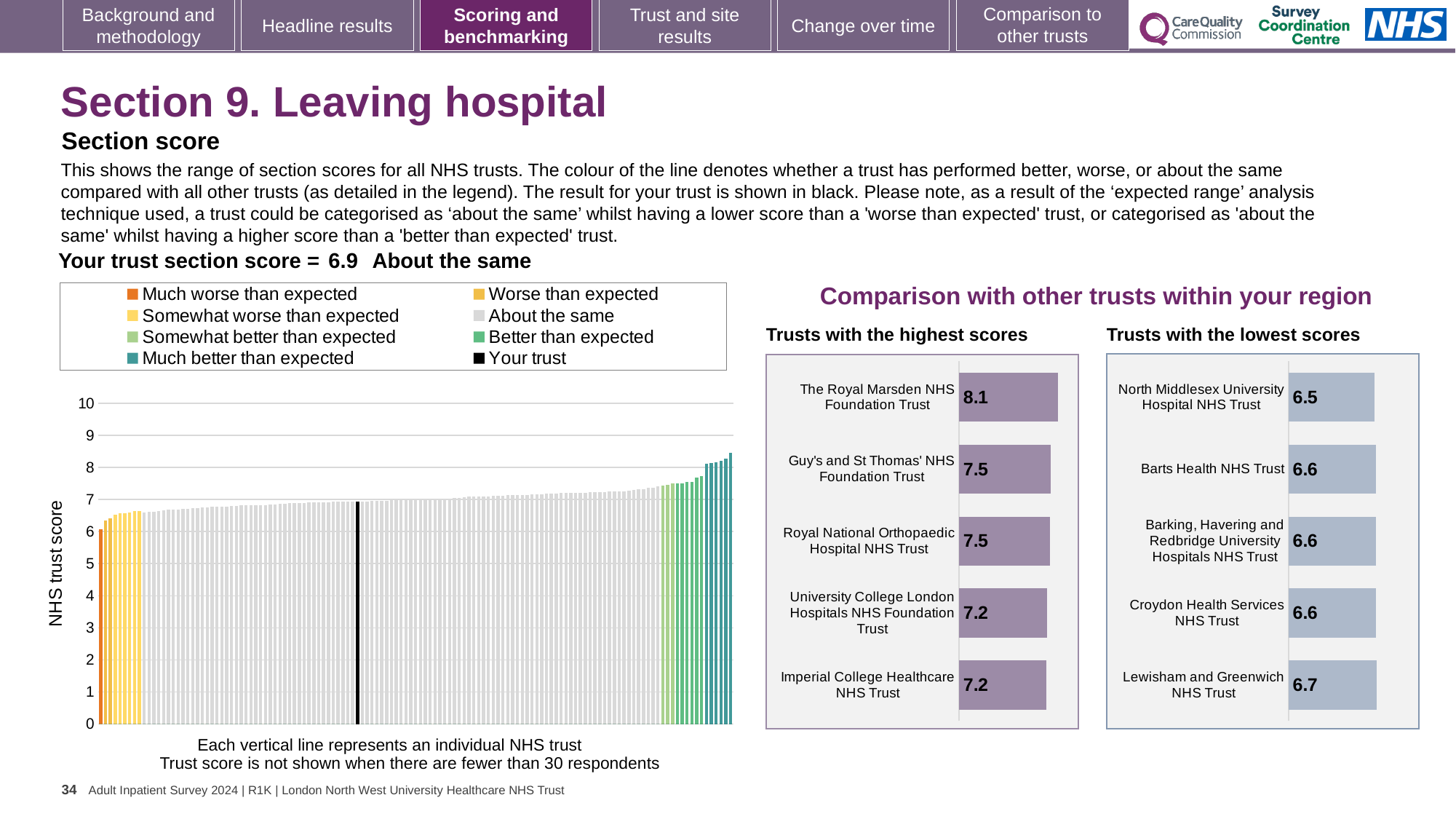
In the 'Trusts with the lowest scores' chart, what is the difference between the scores of Lewisham and Greenwich NHS Trust and North Middlesex University Hospital NHS Trust? 0.2 In the main chart of NHS trust scores on the left, what is the section score of the black bar representing your trust? 6.9 Which is larger: the score for Royal National Orthopaedic Hospital NHS Trust in the highest scores chart or the score for Barts Health NHS Trust in the lowest scores chart? Royal National Orthopaedic Hospital NHS Trust In the 'Trusts with the highest scores' chart, what is the score for Imperial College Healthcare NHS Trust? 7.2 In the 'Trusts with the lowest scores' chart, which trust has the lowest score? North Middlesex University Hospital NHS Trust How many trusts are shown in the 'Trusts with the highest scores' chart? 5 In the 'Trusts with the highest scores' chart, what is the difference between the scores of The Royal Marsden NHS Foundation Trust and Guy's and St Thomas' NHS Foundation Trust? 0.6 In the main chart of NHS trust scores on the left, do the values rise or fall from left to right along the x axis? rise In the 'Trusts with the lowest scores' chart, what is the score for North Middlesex University Hospital NHS Trust? 6.5 In the 'Trusts with the highest scores' chart, what is the score for The Royal Marsden NHS Foundation Trust? 8.1 In the 'Trusts with the lowest scores' chart, what is the score for Lewisham and Greenwich NHS Trust? 6.7 In the 'Trusts with the highest scores' chart, which trust has the highest score? The Royal Marsden NHS Foundation Trust